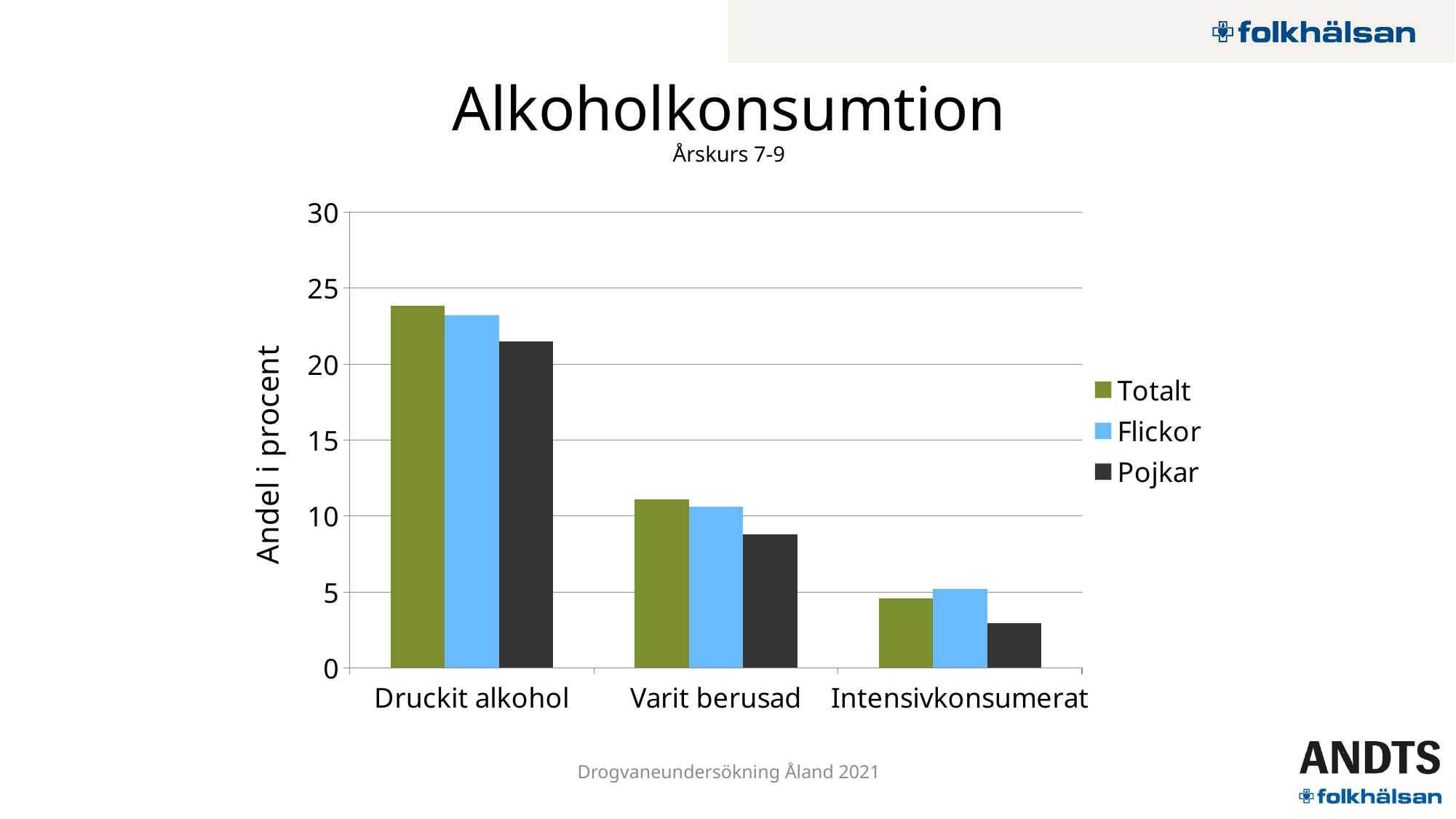
Is the value for Pojkar in Intensivkonsumerat greater or less than 5? less Is the value for Totalt in Druckit alkohol greater or less than 20? greater Which category has the lowest value for Pojkar? Intensivkonsumerat In Druckit alkohol, which is larger: Totalt or Pojkar? Totalt What kind of chart is shown on the slide? bar chart Which category has the highest value for Totalt? Druckit alkohol How many categories are shown on the x axis? 3 In Intensivkonsumerat, which is larger: Flickor or Pojkar? Flickor Do the Totalt values rise or fall from Druckit alkohol to Intensivkonsumerat? fall Is the value for Totalt in Varit berusad greater or less than 10? greater How many series does the legend list? 3